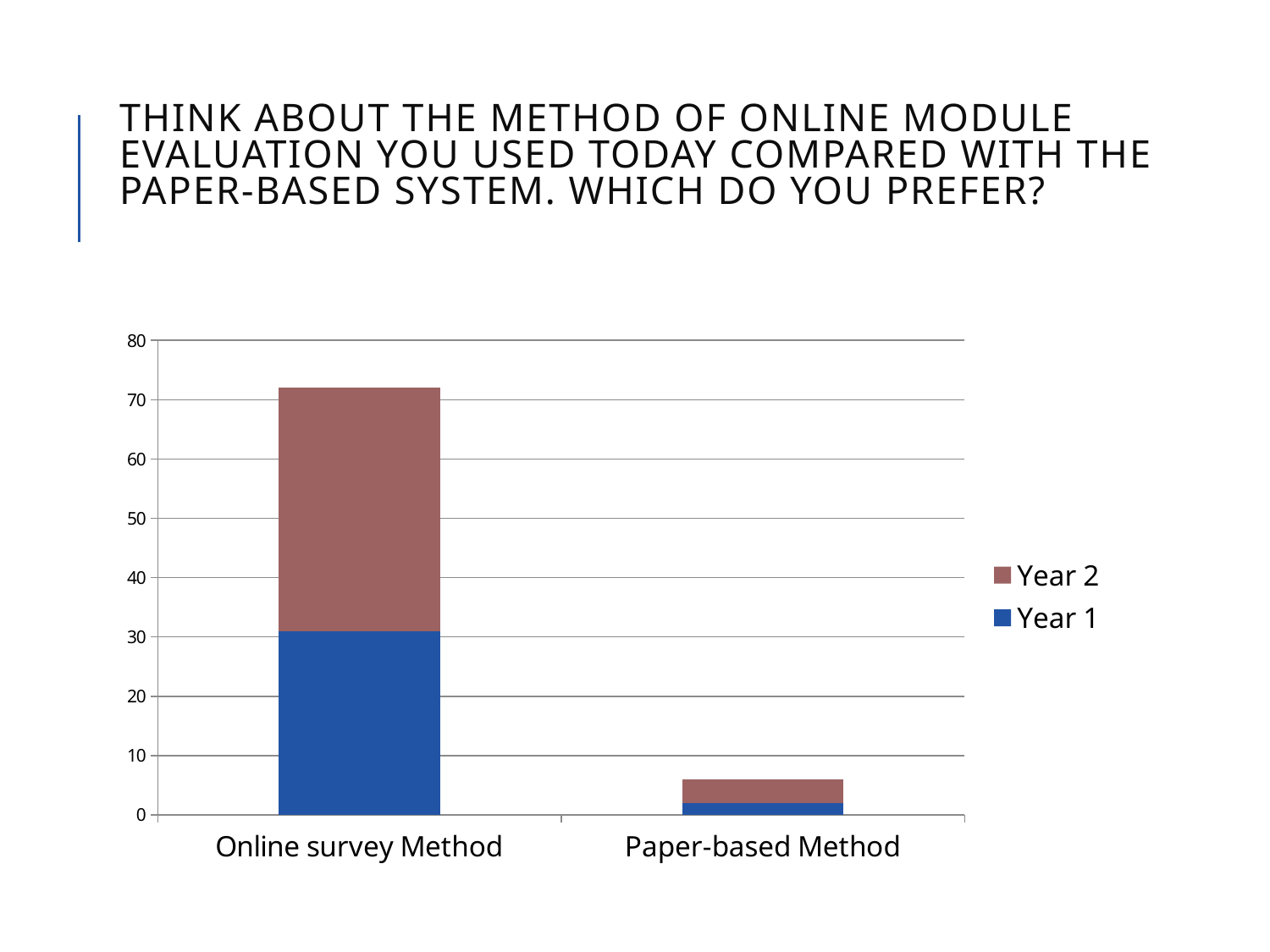
What kind of chart is shown on the slide? stacked bar chart How many categories are shown on the x axis of the chart? 2 Which is larger for Online survey Method: the Year 1 segment or the Year 2 segment? Year 2 Is the total stacked value for Online survey Method greater or less than 70? greater Is the Year 1 value for Online survey Method greater or less than 40? less Is the Year 1 value for Online survey Method greater or less than 20? greater Which category has the taller stacked bar? Online survey Method Which series is shown in blue in the chart? Year 1 What is the highest value shown on the chart's vertical axis? 80 How many series does the chart's legend list? 2 Which category has the shorter stacked bar? Paper-based Method